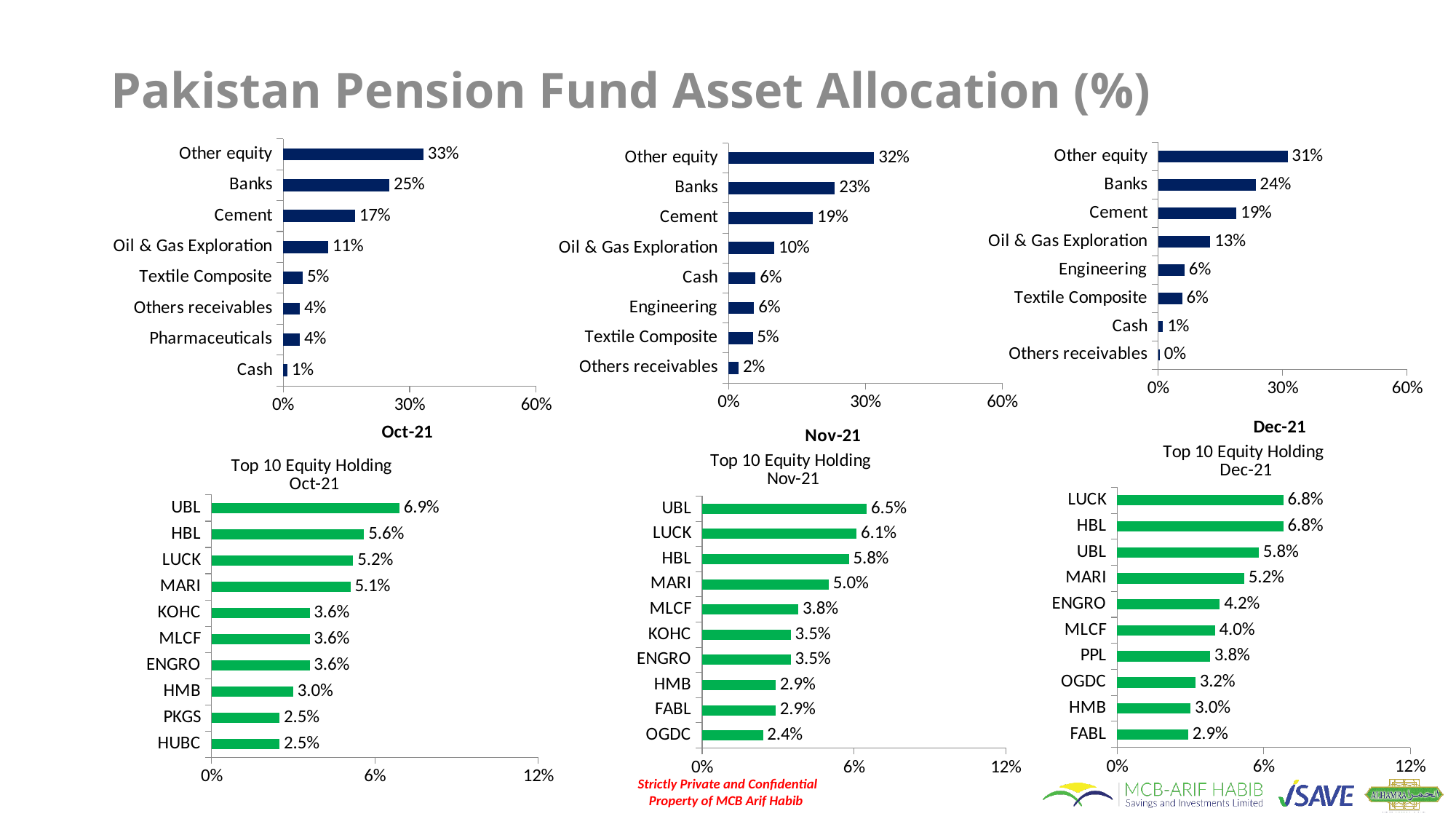
In the Dec-21 asset allocation chart (top right), which category has the highest value? Other equity What type of chart is the Top 10 Equity Holding Dec-21 chart (bottom right)? Bar chart In the Top 10 Equity Holding Oct-21 chart (bottom left), what is the value for MARI? 5.1% In the Oct-21 asset allocation chart (top left), what is the difference between Other equity and Cement? 16% In the Top 10 Equity Holding Nov-21 chart (bottom middle), which is larger, UBL or MARI? UBL In the Oct-21 asset allocation chart (top left), what is the value for Banks? 25% In the Nov-21 asset allocation chart (top middle), what is the value for Oil & Gas Exploration? 10% In the Top 10 Equity Holding Dec-21 chart (bottom right), what is the difference between LUCK and FABL? 3.9% In the Dec-21 asset allocation chart (top right), which category has the lowest value? Others receivables In the Top 10 Equity Holding Dec-21 chart (bottom right), what is the value for PPL? 3.8% How many categories are shown in the Nov-21 asset allocation chart (top middle)? 8 In the Top 10 Equity Holding Nov-21 chart (bottom middle), which holding has the lowest value? OGDC